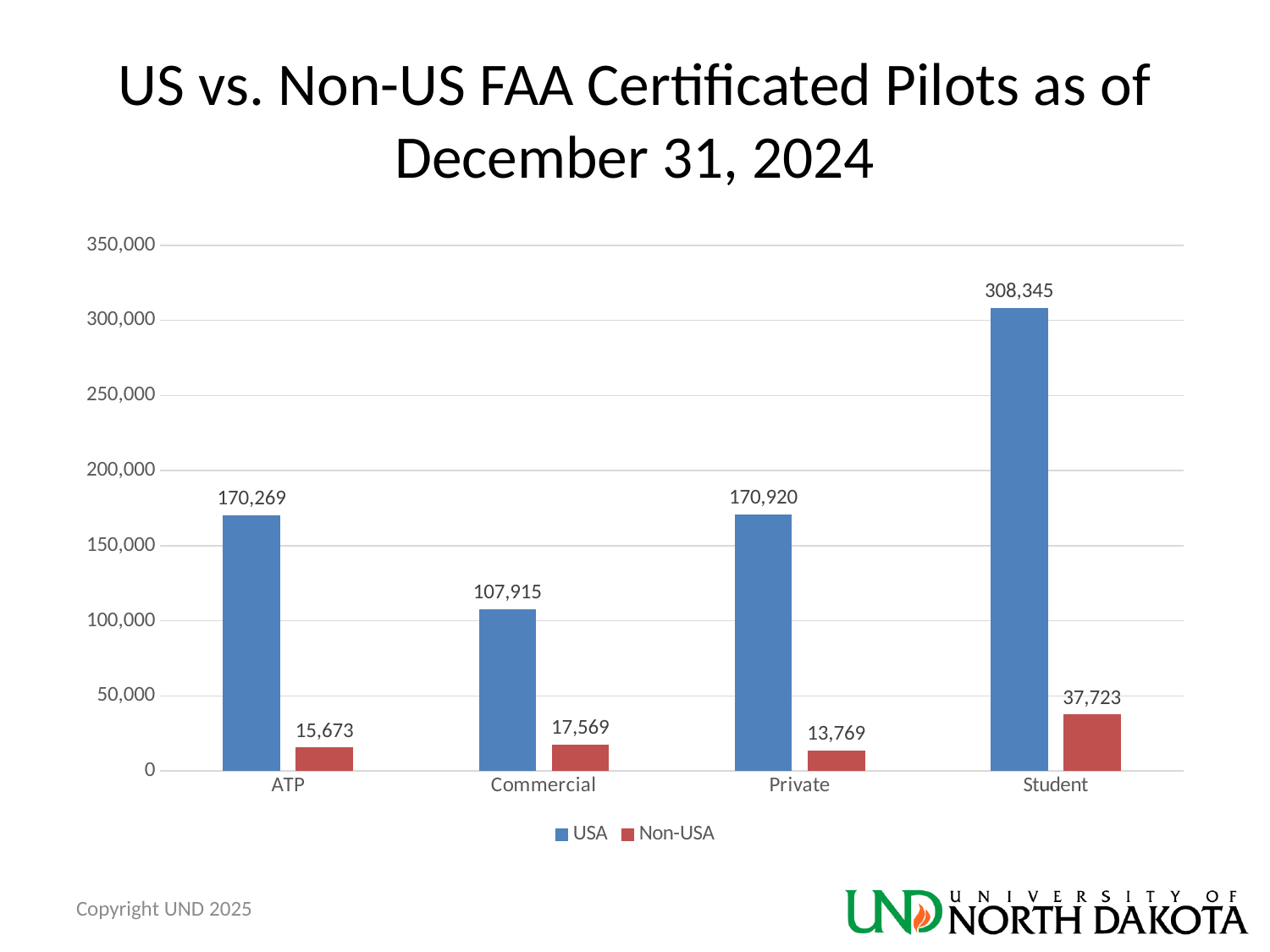
How many series does the legend list? 2 What is the value for Non-USA in the Student category? 37,723 Is the USA value for Student greater or less than 300,000? greater What is the value for USA in the ATP category? 170,269 What is the difference between the USA values for ATP and Commercial? 62,354 What is the difference between the USA and Non-USA values in the Student category? 270,622 Which category has the lowest Non-USA value? Private Which category has the lowest USA value? Commercial Which is larger, the Non-USA value for Commercial or the Non-USA value for Student? Student What is the value for Non-USA in the Private category? 13,769 How many categories are shown on the x axis? 4 Which category has the highest USA value? Student